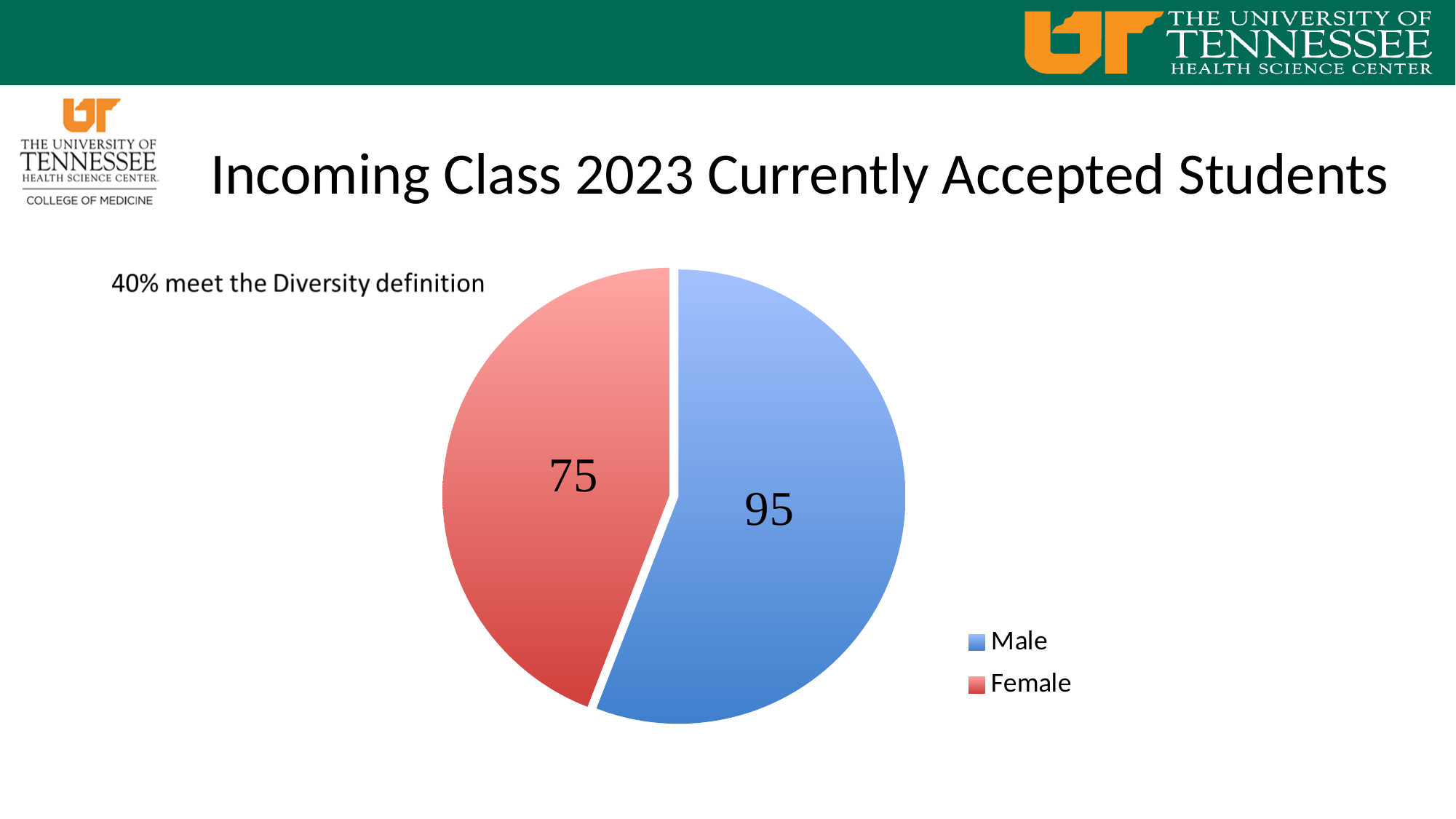
What is the value for Female in the pie chart? 75 What is the difference between the Male and Female values? 20 Which is larger, the Male value or the Female value? Male What percentage of students meet the Diversity definition according to the text on the slide? 40% What is the total of the two slices in the pie chart? 170 Which category has the smallest slice in the pie chart? Female Which category has the largest slice in the pie chart? Male What is the value for Male in the pie chart? 95 What colour is the Female slice in the pie chart? Red How many entries does the legend list? 2 How many slices does the pie chart have? 2 What kind of chart is shown on the slide? Pie chart